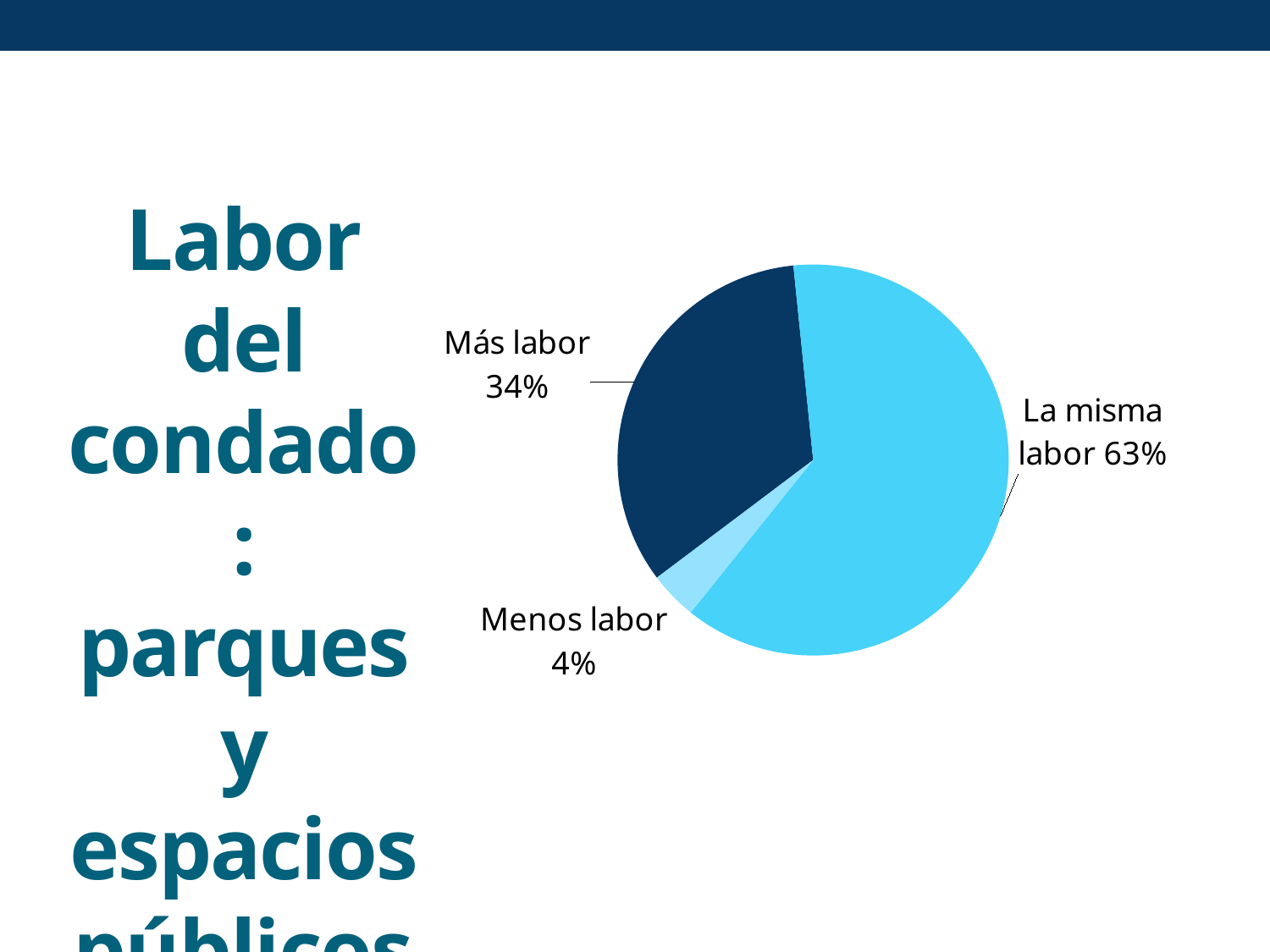
Which is larger, the share for "Más labor" or the share for "Menos labor"? Más labor What share of the pie is labelled "La misma labor"? 63% What is the difference in percentage points between "La misma labor" and "Más labor"? 29 What kind of chart is shown on the slide? pie chart Which slice of the pie is drawn in dark navy blue? Más labor What share of the pie is labelled "Menos labor"? 4% Which slice of the pie is the smallest? Menos labor Is the share for "La misma labor" greater or less than 50%? greater How many slices does the pie chart have? 3 What is the difference in percentage points between "Más labor" and "Menos labor"? 30 Which slice of the pie is the largest? La misma labor What share of the pie is labelled "Más labor"? 34%